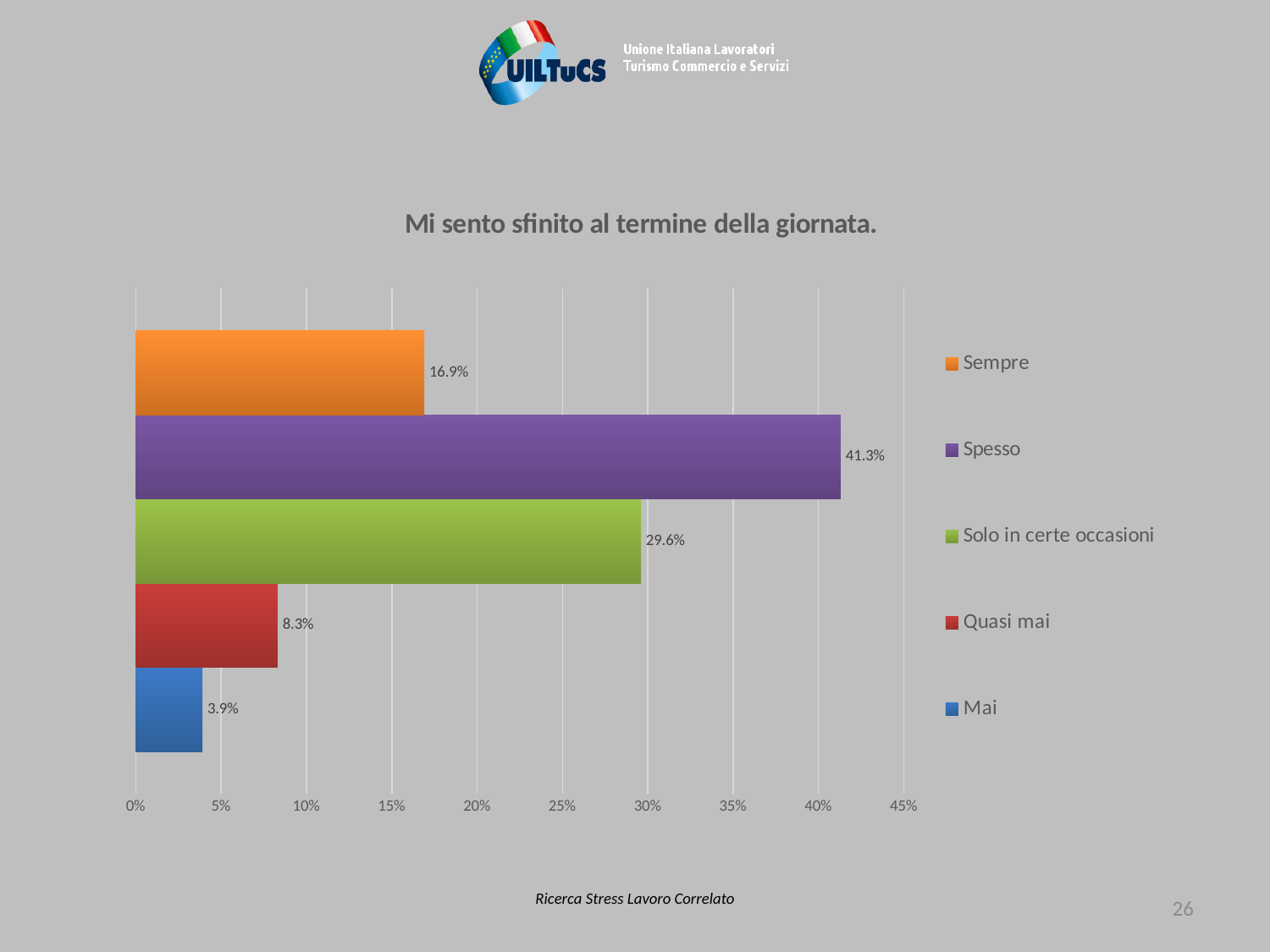
Which category has the highest value? Spesso Which is larger, the value for Sempre or the value for Quasi mai? Sempre What is the value for Quasi mai? 8.3% Is the value for Solo in certe occasioni greater or less than 25%? greater Which category has the lowest value? Mai What is the value for Mai? 3.9% How many categories are shown in the chart? 5 What is the difference between the values for Spesso and Sempre? 24.4% What is the value for Spesso? 41.3% What kind of chart is shown on the slide? bar chart What is the value for Solo in certe occasioni? 29.6% What is the title of the chart? Mi sento sfinito al termine della giornata.